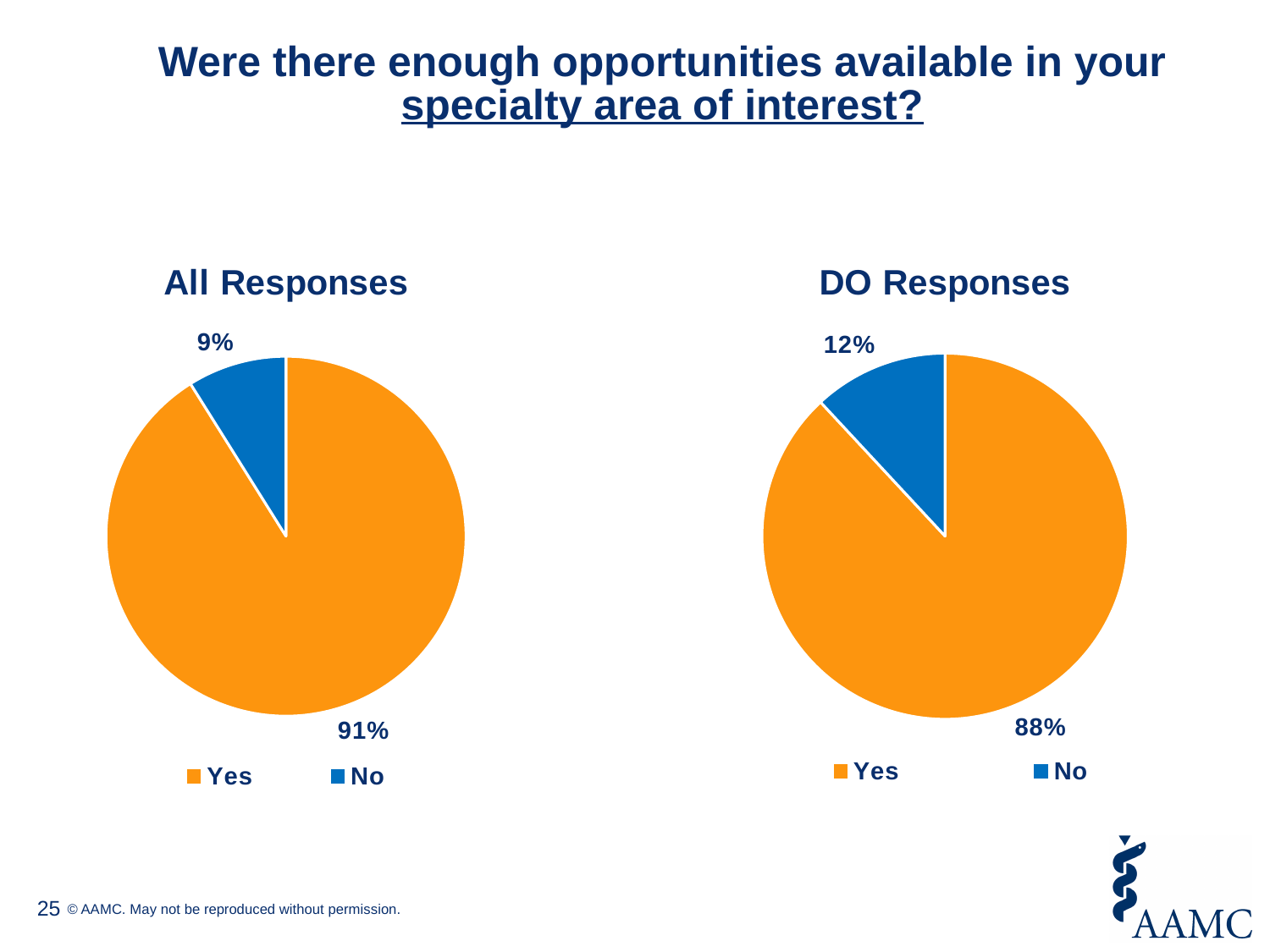
In the "DO Responses" chart, what percentage of respondents answered No? 12% What type of chart is the "All Responses" chart? Pie chart How many entries does the legend of the "DO Responses" chart list? 2 In the "All Responses" chart, what is the difference between the Yes and No shares? 82% Is the No share larger in the "All Responses" chart or the "DO Responses" chart? DO Responses In the "All Responses" chart, which response has the largest share? Yes In the "All Responses" chart, what percentage of respondents answered No? 9% In the "DO Responses" chart, what is the difference between the Yes and No shares? 76% In the "All Responses" chart, what colour represents the Yes slice? Orange In the "All Responses" chart, what percentage of respondents answered Yes? 91% In the "DO Responses" chart, what percentage of respondents answered Yes? 88% In the "DO Responses" chart, which response has the smallest share? No